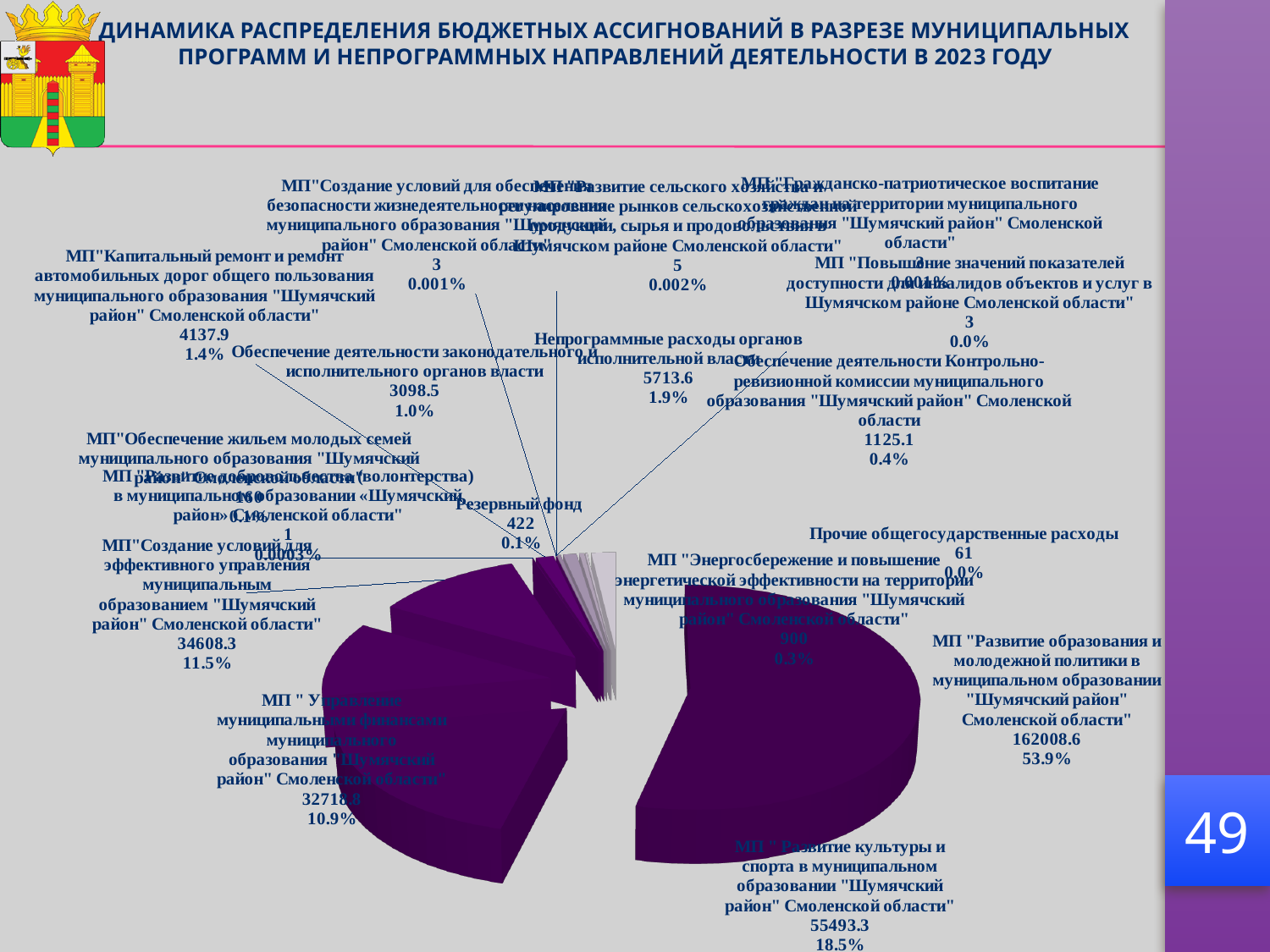
What is the difference between the values for МП "Развитие образования и молодежной политики" and МП "Развитие культуры и спорта"? 106515.3 What value is shown for Обеспечение деятельности Контрольно-ревизионной комиссии муниципального образования? 1125.1 What value is shown for МП "Создание условий для эффективного управления муниципальным образованием"? 34608.3 What value is shown for Резервный фонд? 422 Which is larger: the value for МП "Развитие культуры и спорта" or the value for МП "Создание условий для эффективного управления муниципальным образованием"? МП "Развитие культуры и спорта" What value is shown for МП "Развитие культуры и спорта в муниципальном образовании "Шумячский район" Смоленской области"? 55493.3 Which category has the largest share of the pie? МП "Развитие образования и молодежной политики в муниципальном образовании "Шумячский район" Смоленской области" What share of the pie does МП "Развитие культуры и спорта" hold? 18.5% What share of the pie does МП "Капитальный ремонт и ремонт автомобильных дорог общего пользования" hold? 1.4% What value is shown for Непрограммные расходы органов исполнительной власти? 5713.6 What share of the pie does МП "Развитие образования и молодежной политики" hold? 53.9% What kind of chart is shown on the slide? pie chart